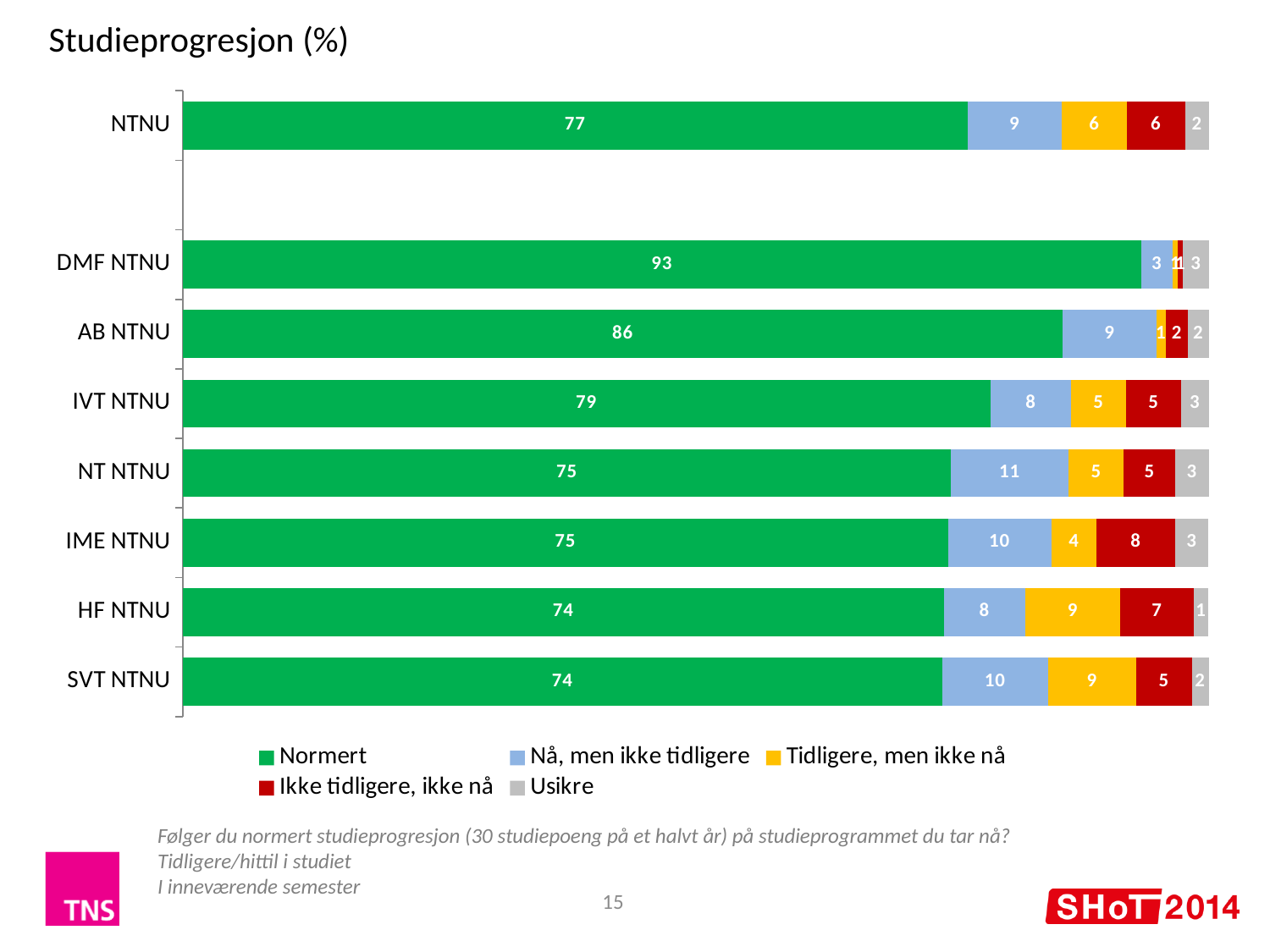
Which has a larger 'Tidligere, men ikke nå' value, HF NTNU or IVT NTNU? HF NTNU What is the Normert value for NTNU? 77 What is the total of the stacked bar for NTNU? 100 What is the Normert value for DMF NTNU? 93 Which category has the lowest 'Nå, men ikke tidligere' value? DMF NTNU What kind of chart is shown on the slide? Stacked bar chart How many categories are shown on the chart? 8 What is the difference between the Normert values for DMF NTNU and AB NTNU? 7 How many series does the legend list? 5 What is the 'Ikke tidligere, ikke nå' value for IME NTNU? 8 What is the 'Nå, men ikke tidligere' value for NT NTNU? 11 Which category has the highest Normert value? DMF NTNU